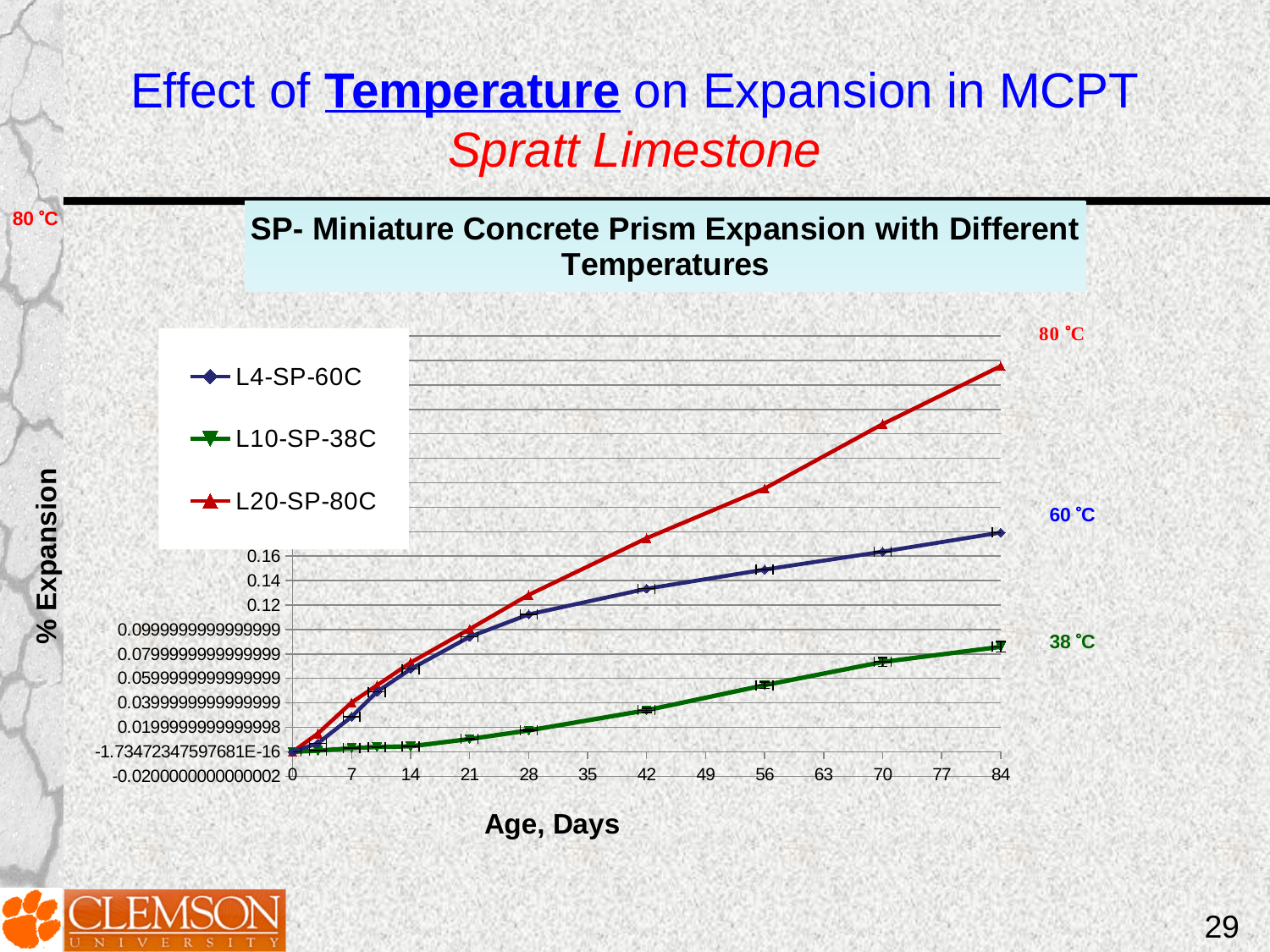
Which series has the highest expansion at 84 days? L20-SP-80C Is the value for L10-SP-38C at 84 days greater or less than 0.12? less Is the value for L4-SP-60C at 84 days greater or less than 0.16? greater What is the title of the chart? SP- Miniature Concrete Prism Expansion with Different Temperatures Is the value for L4-SP-60C at 28 days greater or less than 0.14? less What kind of chart is shown on the slide? line chart At 56 days, which series has the larger expansion, L4-SP-60C or L10-SP-38C? L4-SP-60C How many series does the legend list? 3 Do the expansion values for L20-SP-80C rise or fall as age increases? rise Which series has the lowest expansion at 84 days? L10-SP-38C What is the label of the x axis? Age, Days